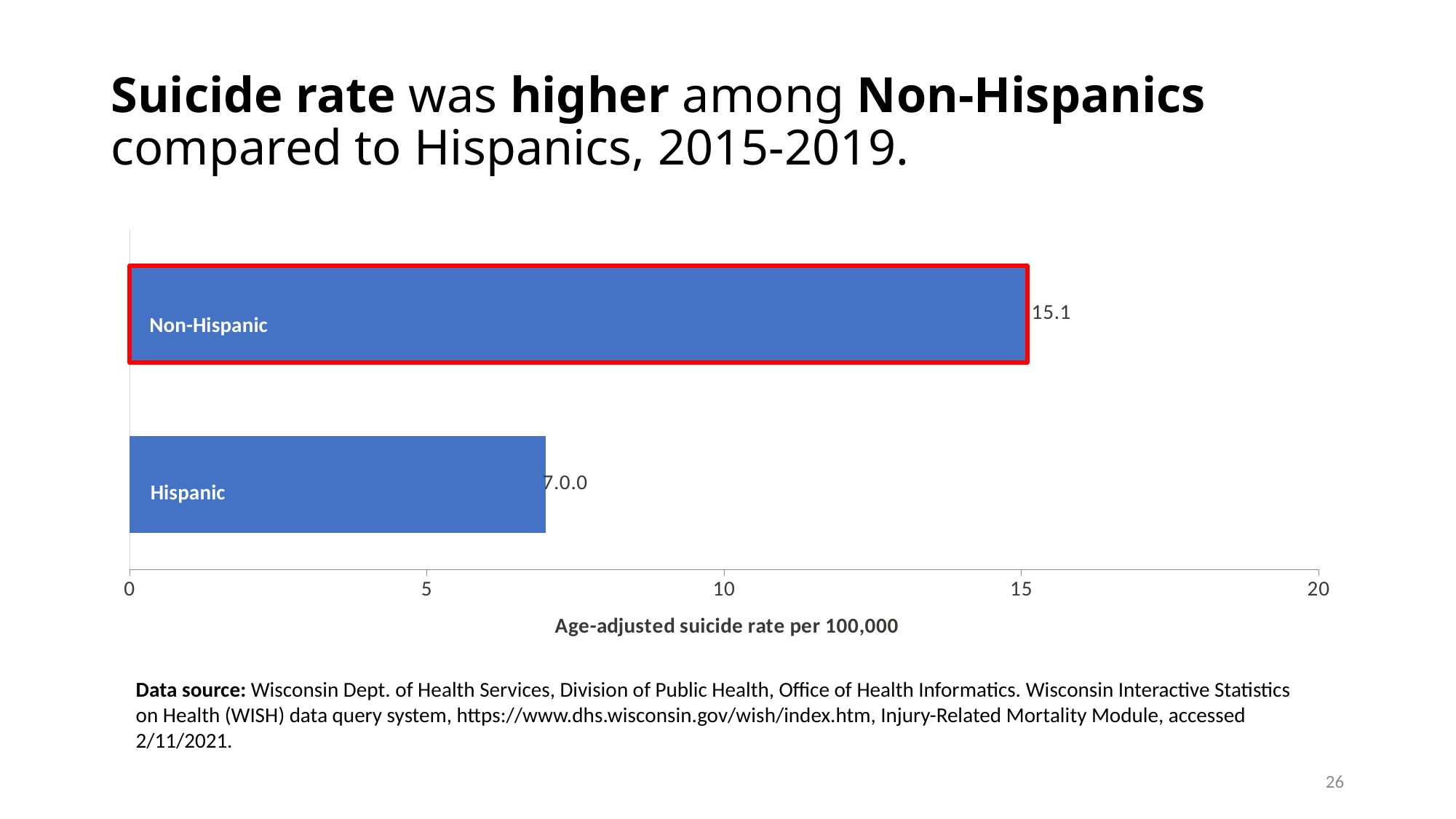
Is the value for Hispanic greater or less than 5? greater What is the maximum value shown on the horizontal axis? 20 How many groups are shown in the chart? 2 What is the age-adjusted suicide rate per 100,000 for Non-Hispanic? 15.1 Is the suicide rate for Non-Hispanic larger or smaller than the rate for Hispanic? larger Which group has the lower age-adjusted suicide rate? Hispanic Is the value for Non-Hispanic greater or less than 15? greater What type of chart is shown on the slide? bar chart Which bar is outlined in red? Non-Hispanic What is the label of the horizontal axis? Age-adjusted suicide rate per 100,000 Which group has the higher age-adjusted suicide rate? Non-Hispanic Is the value for Hispanic greater or less than 10? less